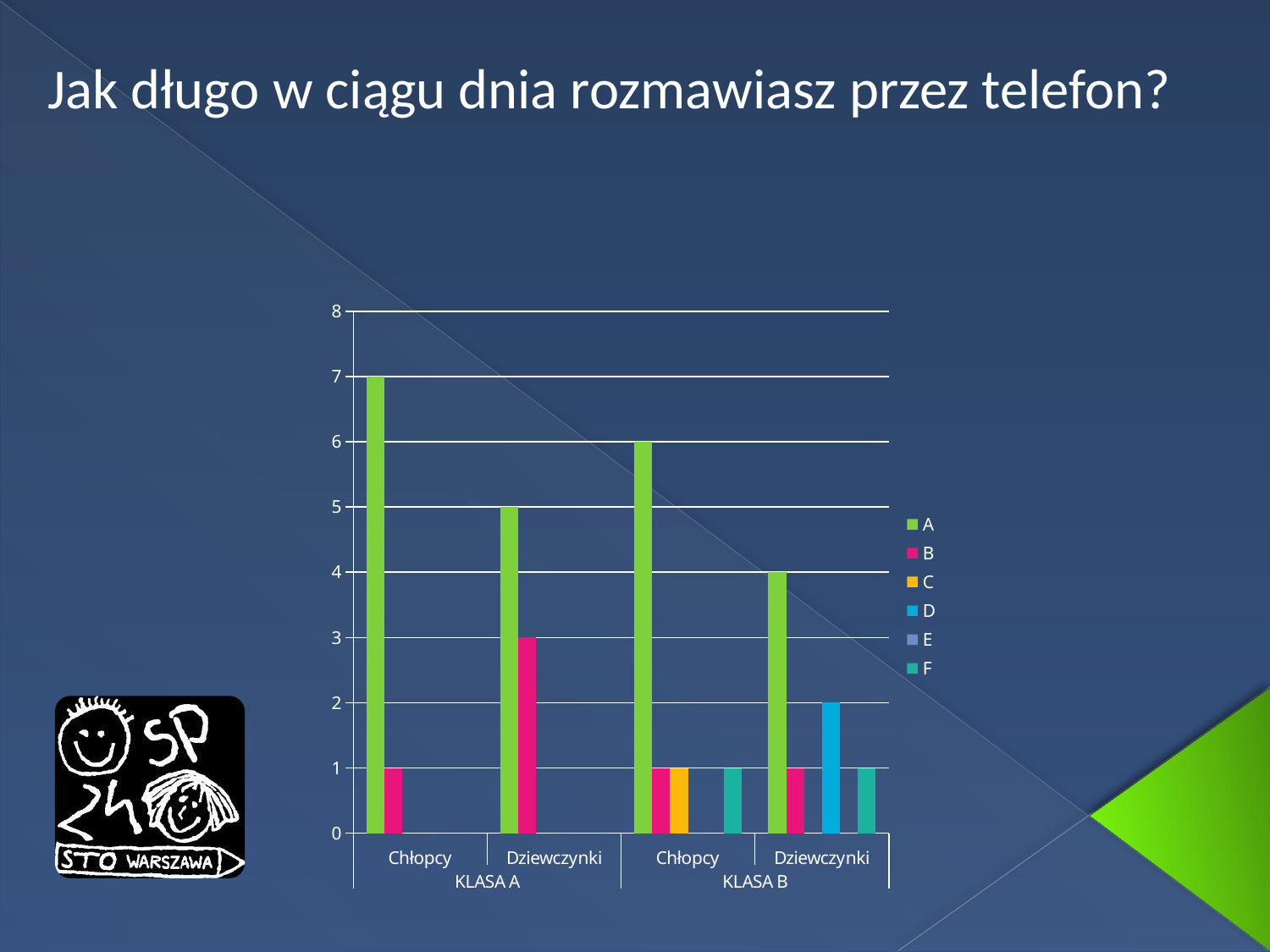
What is the value of series A for Chłopcy in KLASA A? 7 What is the title of the slide? Jak długo w ciągu dnia rozmawiasz przez telefon? Which is larger: series A for Dziewczynki in KLASA A or series A for Chłopcy in KLASA B? Chłopcy in KLASA B Which category has the lowest value for series A? Dziewczynki, KLASA B How many categories are shown on the x axis? 4 Which category has the highest value for series A? Chłopcy, KLASA A What is the value of series B for Dziewczynki in KLASA A? 3 What is the difference between the series A values for Chłopcy in KLASA A and Chłopcy in KLASA B? 1 What kind of chart is shown on the slide? bar chart What is the value of series D for Dziewczynki in KLASA B? 2 How many series does the legend list? 6 What is the value of series A for Dziewczynki in KLASA B? 4